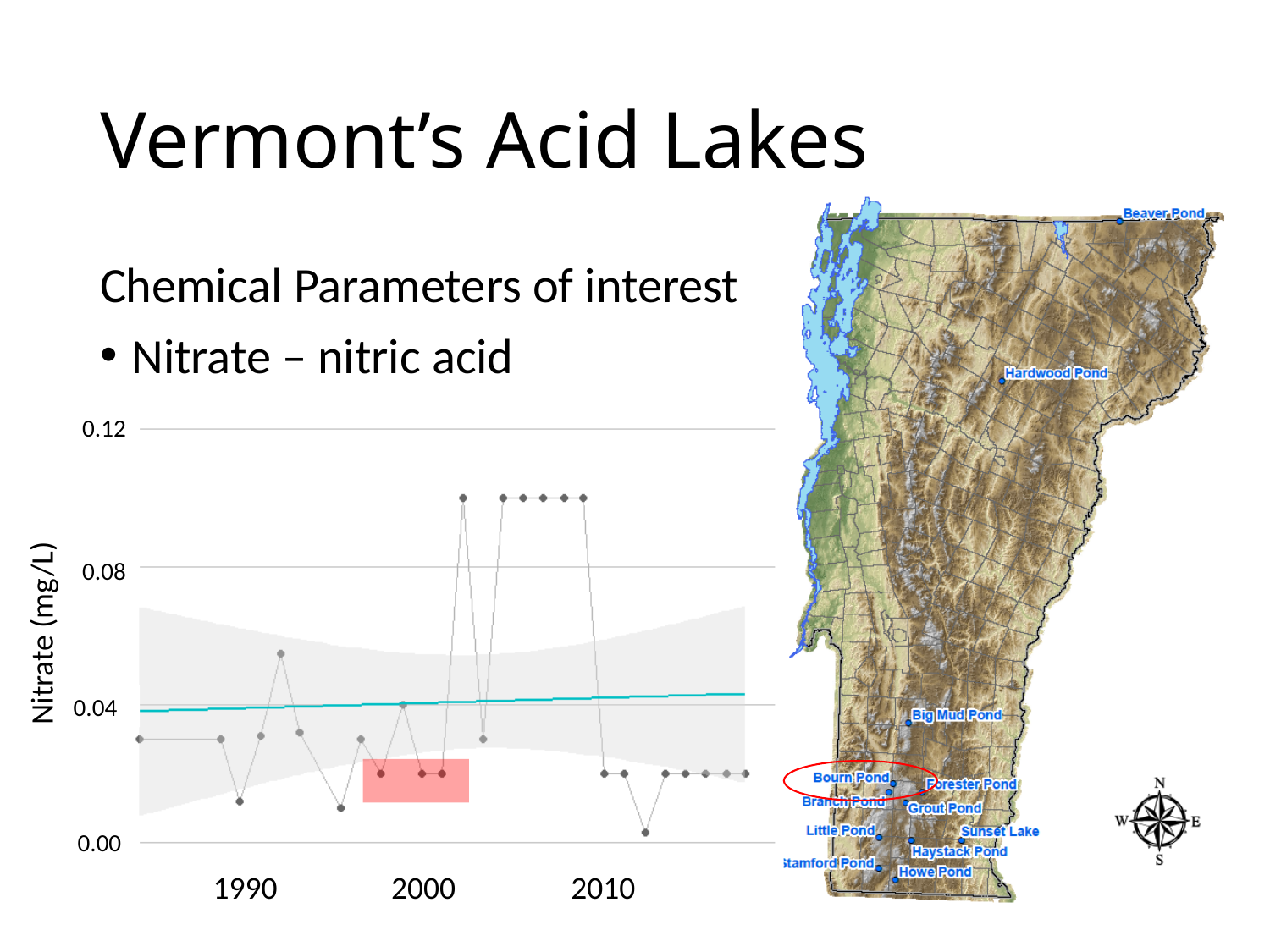
What is the label on the y axis of the chart? Nitrate (mg/L) Is the plotted nitrate value at 2000 greater or less than 0.04? less What kind of chart is shown on the slide? line chart Does the cyan trend line on the chart rise or fall from left to right? rises Is the plotted nitrate value at 2010 greater or less than 0.04? less Is the plotted nitrate value at 1990 greater or less than 0.04? less Is the plotted nitrate value around 2005 larger or smaller than the value at 2010? larger Which years are labelled as ticks on the x axis of the chart? 1990, 2000, 2010